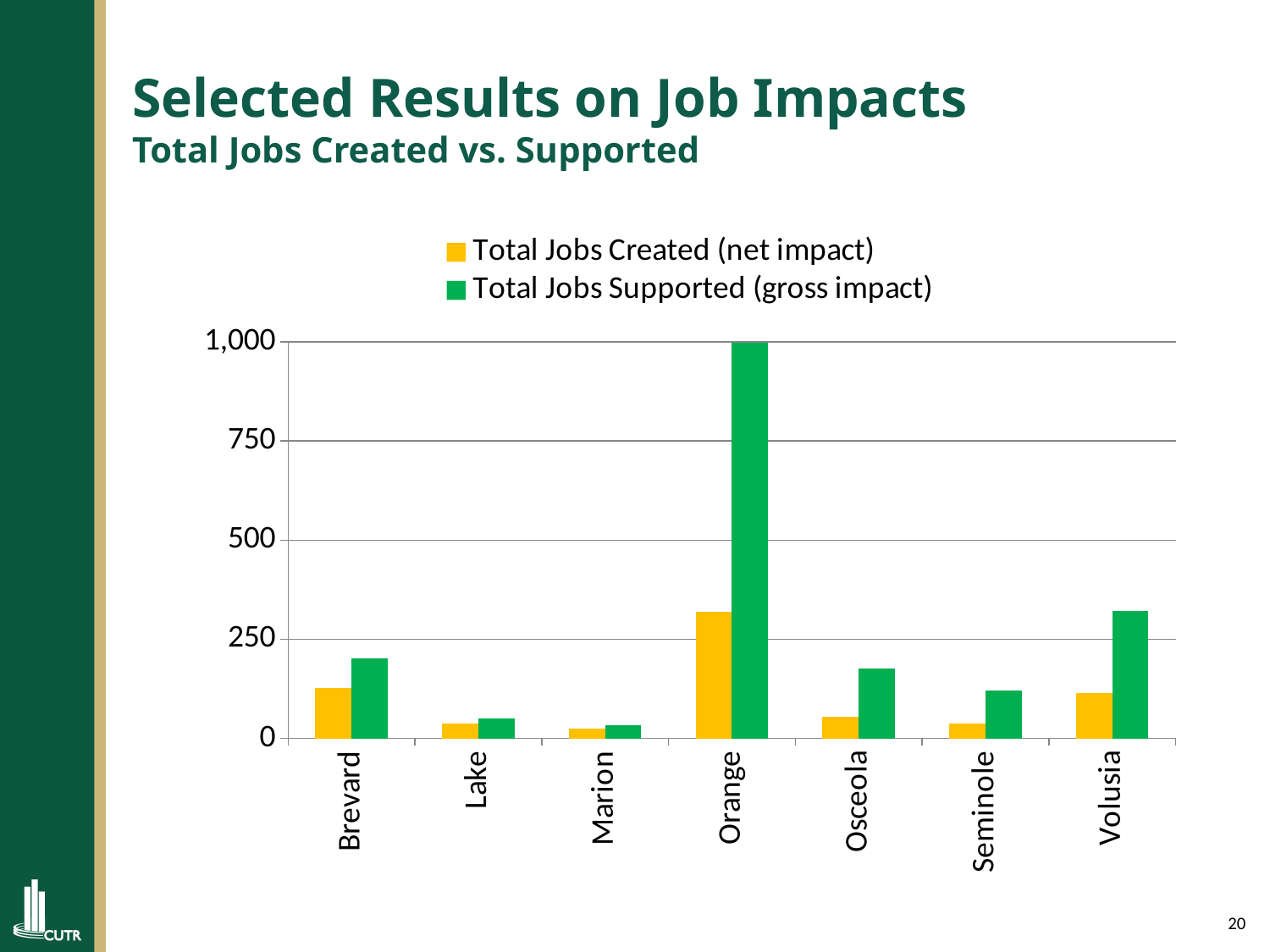
How many series does the chart's legend list? 2 Which county has the lowest value for Total Jobs Supported (gross impact)? Marion Which county has the larger Total Jobs Supported (gross impact) value, Volusia or Brevard? Volusia Is the Total Jobs Supported (gross impact) value for Orange greater or less than 750? greater Is the Total Jobs Supported (gross impact) value for Brevard greater or less than 250? less Is the Total Jobs Created (net impact) value for Orange greater or less than 250? greater How many counties are shown on the x axis of the chart? 7 What kind of chart is shown on the slide? bar chart What is the subtitle of the chart on the slide? Total Jobs Created vs. Supported Which county has the highest value for Total Jobs Created (net impact)? Orange Which county has the highest value for Total Jobs Supported (gross impact)? Orange Which series is shown in green in the chart's legend? Total Jobs Supported (gross impact)